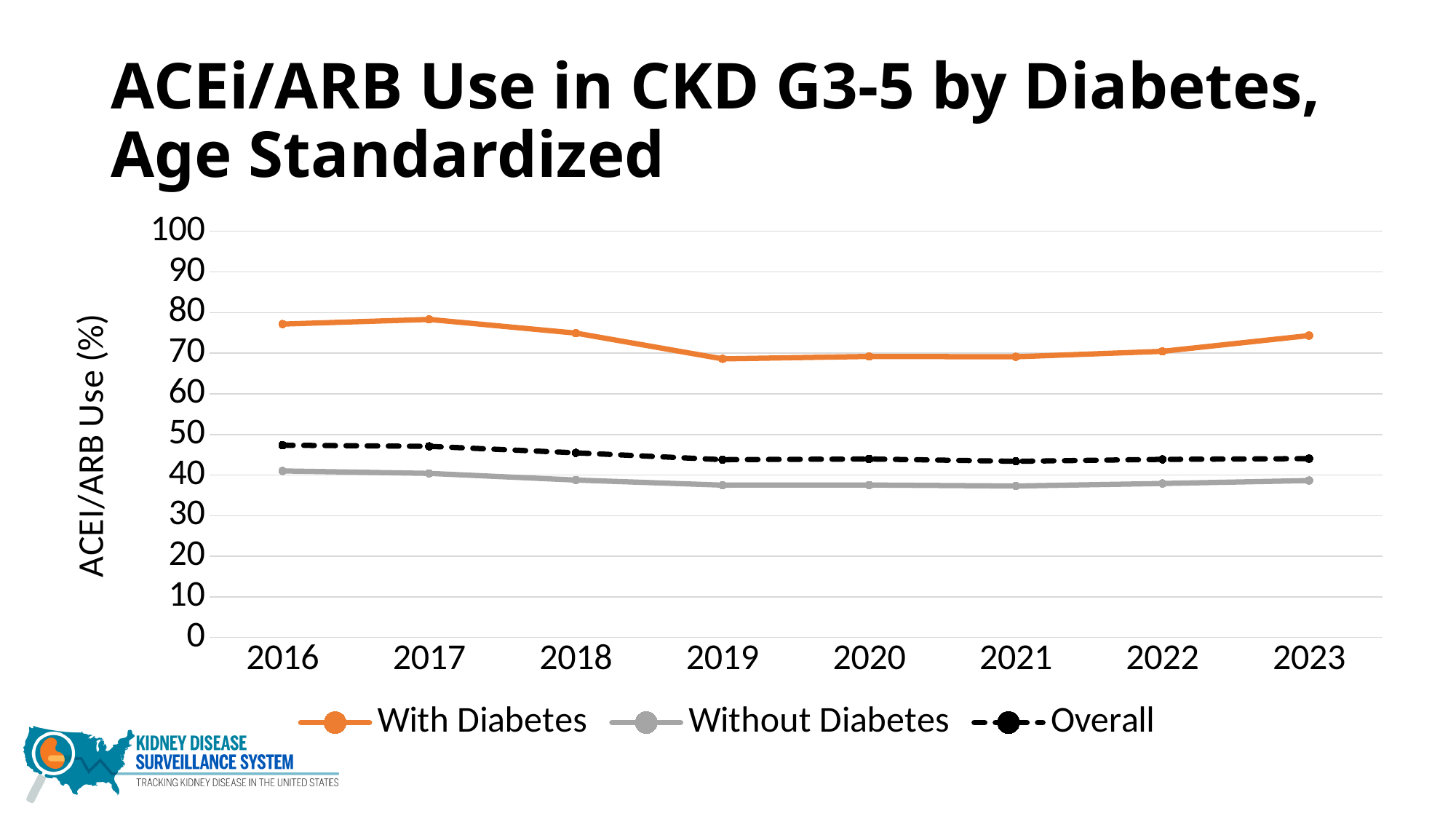
Does the With Diabetes line rise or fall from 2017 to 2019? Fall Which series is drawn with a dashed black line? Overall Is the value for Overall in 2021 greater or less than 40? greater What kind of chart is shown on the slide? Line chart Is the value for With Diabetes in 2016 greater or less than 70? greater Is the value for With Diabetes in 2019 greater or less than 70? less What is the label on the y axis? ACEi/ARB Use (%) How many years are plotted along the x axis? 8 In 2023, which series has the higher value: With Diabetes or Without Diabetes? With Diabetes How many series does the legend list? 3